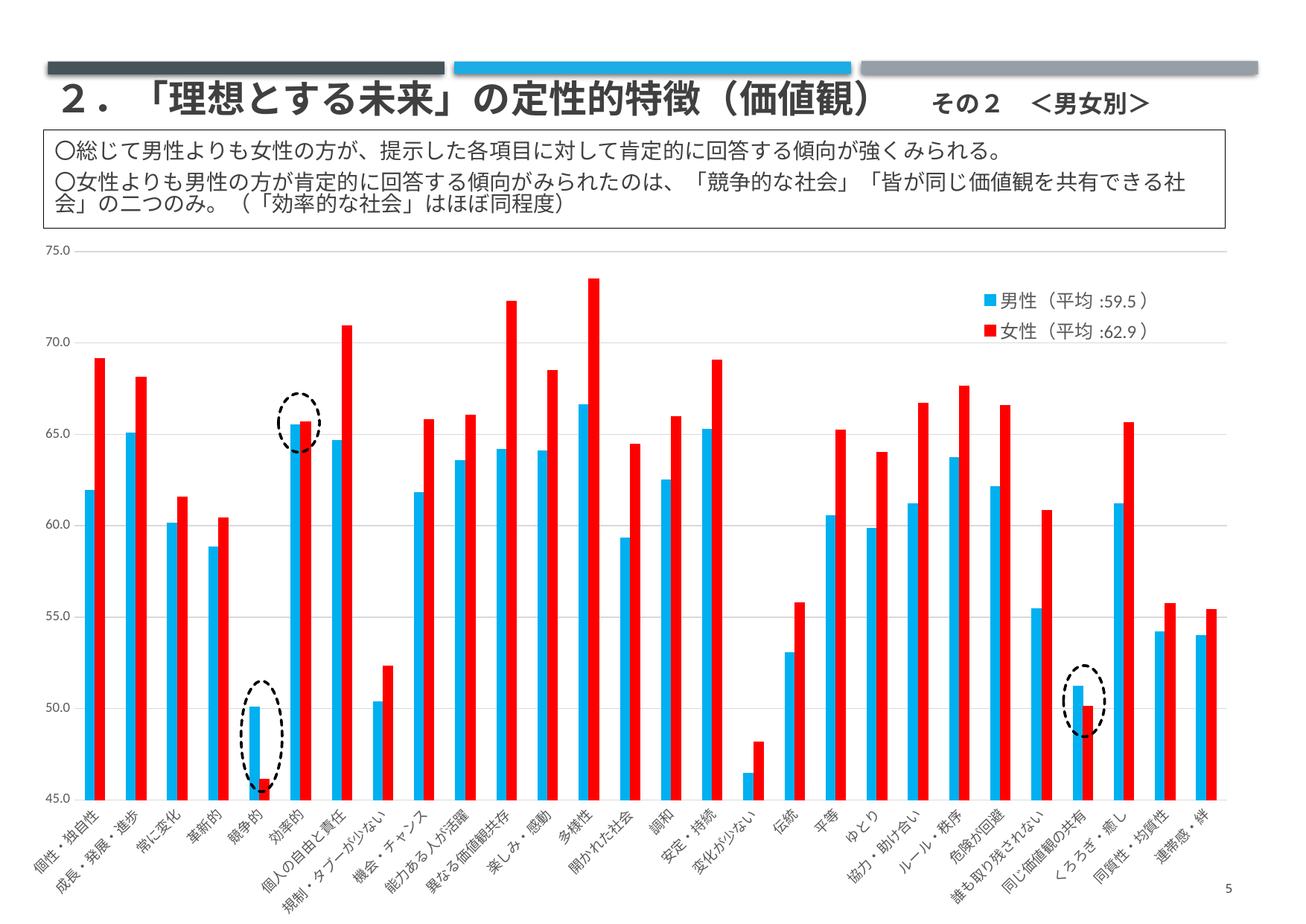
For 競争的, which is larger, the value for 男性 or for 女性? 男性 Which category has the highest value for 女性? 多様性 How many series does the legend list? 2 Which category has the lowest value for 女性? 競争的 For 同じ価値観の共有, which is larger, the value for 男性 or for 女性? 男性 Which category has the lowest value for 男性? 変化が少ない Is the value for 男性 in 変化が少ない greater or less than 50? less How many categories are shown along the x axis? 28 Is the value for 男性 in 伝統 greater or less than 55? less What average value does the legend give for 女性? 62.9 What kind of chart is shown on the slide? bar chart Is the value for 女性 in 多様性 greater or less than 70? greater